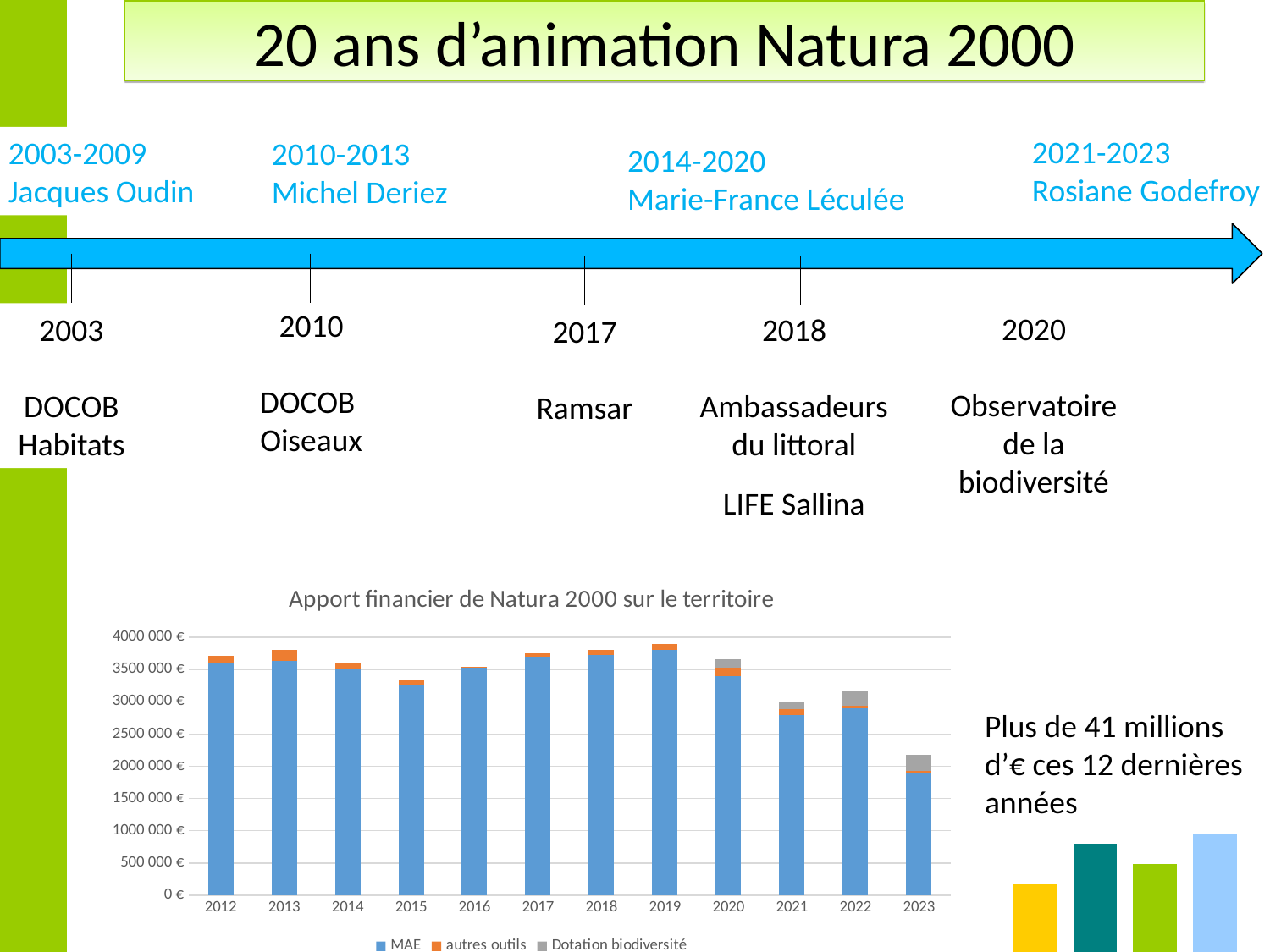
In the chart 'Apport financier de Natura 2000 sur le territoire', which total bar is taller, 2012 or 2023? 2012 How many series does the legend of the chart 'Apport financier de Natura 2000 sur le territoire' list? 3 In the chart 'Apport financier de Natura 2000 sur le territoire', is the total for 2015 greater or less than 3 000 000 €? greater In the chart 'Apport financier de Natura 2000 sur le territoire', do the total bars rise or fall from 2019 to 2023? fall In the chart 'Apport financier de Natura 2000 sur le territoire', is the total for 2019 greater or less than 3 500 000 €? greater What kind of chart is 'Apport financier de Natura 2000 sur le territoire'? stacked bar chart In the chart 'Apport financier de Natura 2000 sur le territoire', is the total for 2023 greater or less than 2 500 000 €? less In the chart 'Apport financier de Natura 2000 sur le territoire', which series makes up the largest part of every bar? MAE How many years are shown on the x axis of the chart 'Apport financier de Natura 2000 sur le territoire'? 12 In the chart 'Apport financier de Natura 2000 sur le territoire', which year has the lowest total bar? 2023 What are the three series listed in the legend of the chart 'Apport financier de Natura 2000 sur le territoire'? MAE, autres outils, Dotation biodiversité